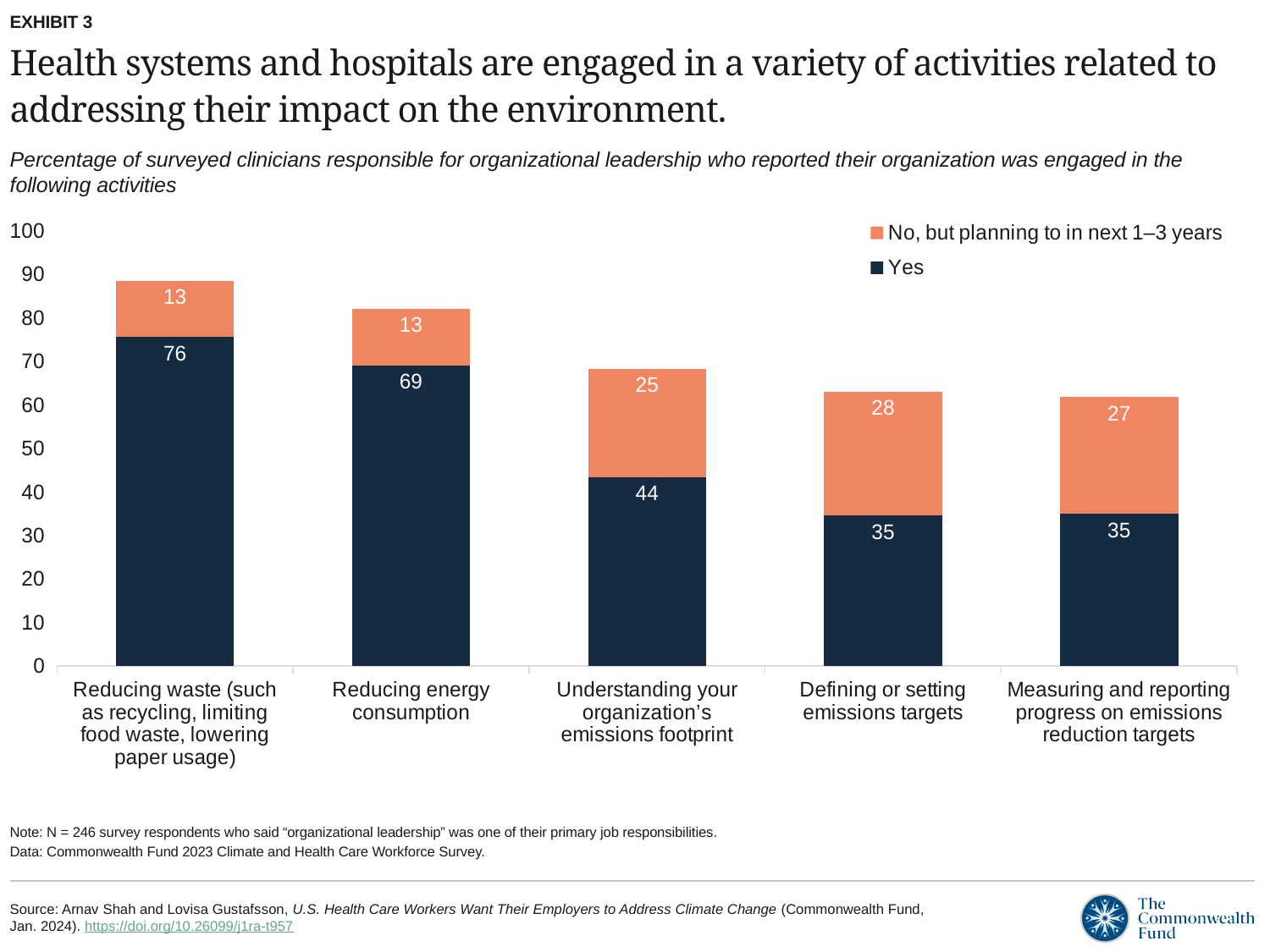
What percentage reported 'Yes' for reducing waste (such as recycling, limiting food waste, lowering paper usage)? 76 What kind of chart is shown? Stacked bar chart How many series does the legend list? 2 What is the total of the stacked bar for defining or setting emissions targets? 63 Which is larger: the 'Yes' value for understanding your organization's emissions footprint or the 'Yes' value for measuring and reporting progress on emissions reduction targets? Understanding your organization's emissions footprint What is the total of the stacked bar for reducing energy consumption? 82 Which activity has the highest 'Yes' value? Reducing waste (such as recycling, limiting food waste, lowering paper usage) How many activities are shown on the x axis? 5 What is the difference between the 'Yes' values for reducing waste and reducing energy consumption? 7 Which activity has the lowest 'No, but planning to in next 1–3 years' value? Reducing waste and reducing energy consumption (both 13) What is the 'No, but planning to in next 1–3 years' value for understanding your organization's emissions footprint? 25 What is the 'Yes' value for defining or setting emissions targets? 35